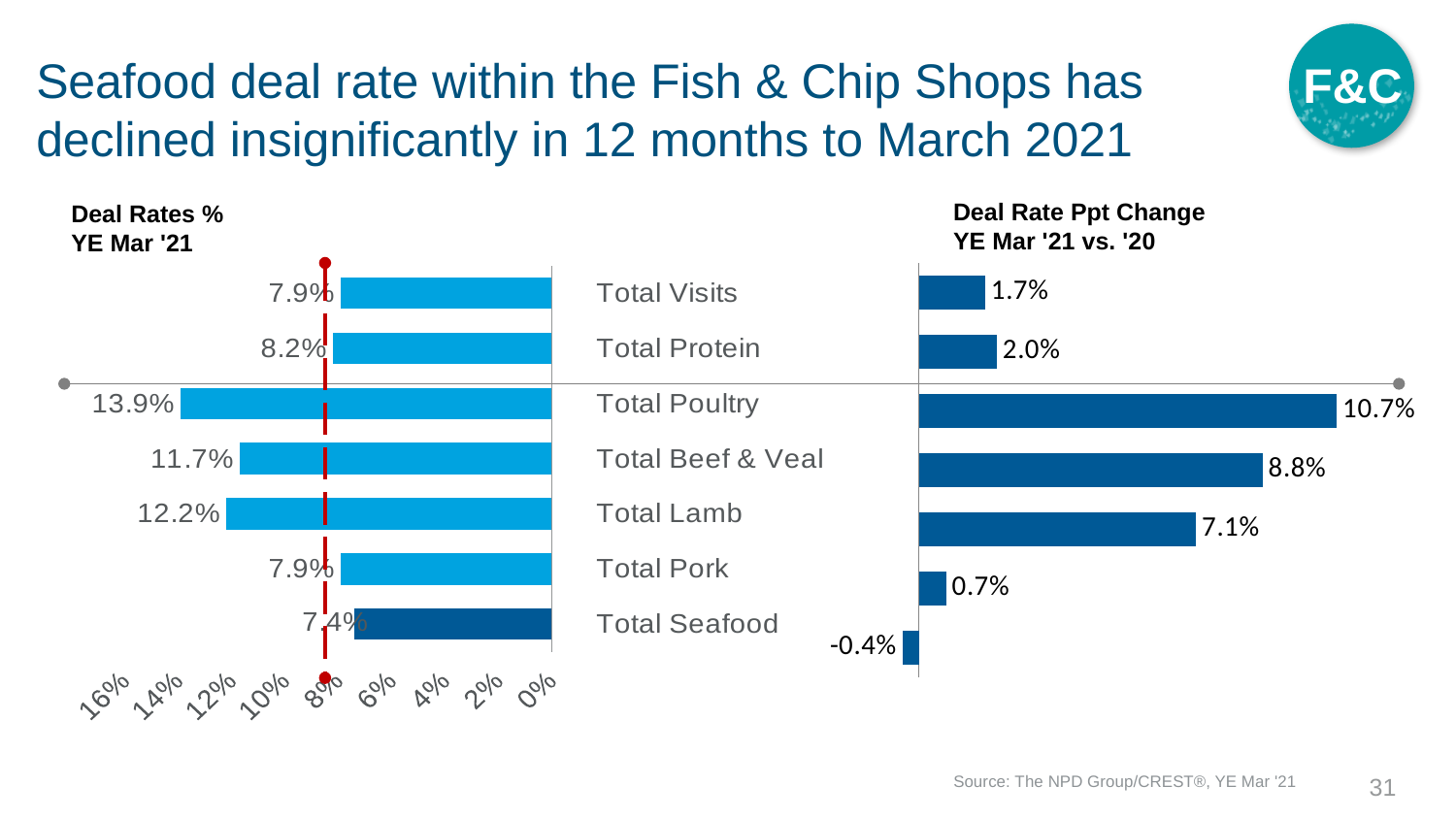
In the Deal Rates % YE Mar '21 chart, what is the deal rate for Total Poultry? 13.9% In the Deal Rates % YE Mar '21 chart, what is the difference between the deal rates for Total Lamb and Total Beef & Veal? 0.5% In the Deal Rates % YE Mar '21 chart, which category has the highest deal rate? Total Poultry In the Deal Rates % YE Mar '21 chart, which category has the lowest deal rate? Total Seafood What kind of chart is the Deal Rate Ppt Change YE Mar '21 vs. '20 chart? Bar chart In the Deal Rate Ppt Change YE Mar '21 vs. '20 chart, which category has the lowest value? Total Seafood In the Deal Rate Ppt Change YE Mar '21 vs. '20 chart, what is the value for Total Seafood? -0.4% In the Deal Rate Ppt Change YE Mar '21 vs. '20 chart, which is larger: the value for Total Poultry or Total Lamb? Total Poultry In the Deal Rates % YE Mar '21 chart, which category's bar is shown in a darker blue than the others? Total Seafood In the Deal Rate Ppt Change YE Mar '21 vs. '20 chart, what is the value for Total Beef & Veal? 8.8% How many categories are shown in the Deal Rates % YE Mar '21 chart? 7 In the Deal Rates % YE Mar '21 chart, what is the deal rate for Total Seafood? 7.4%